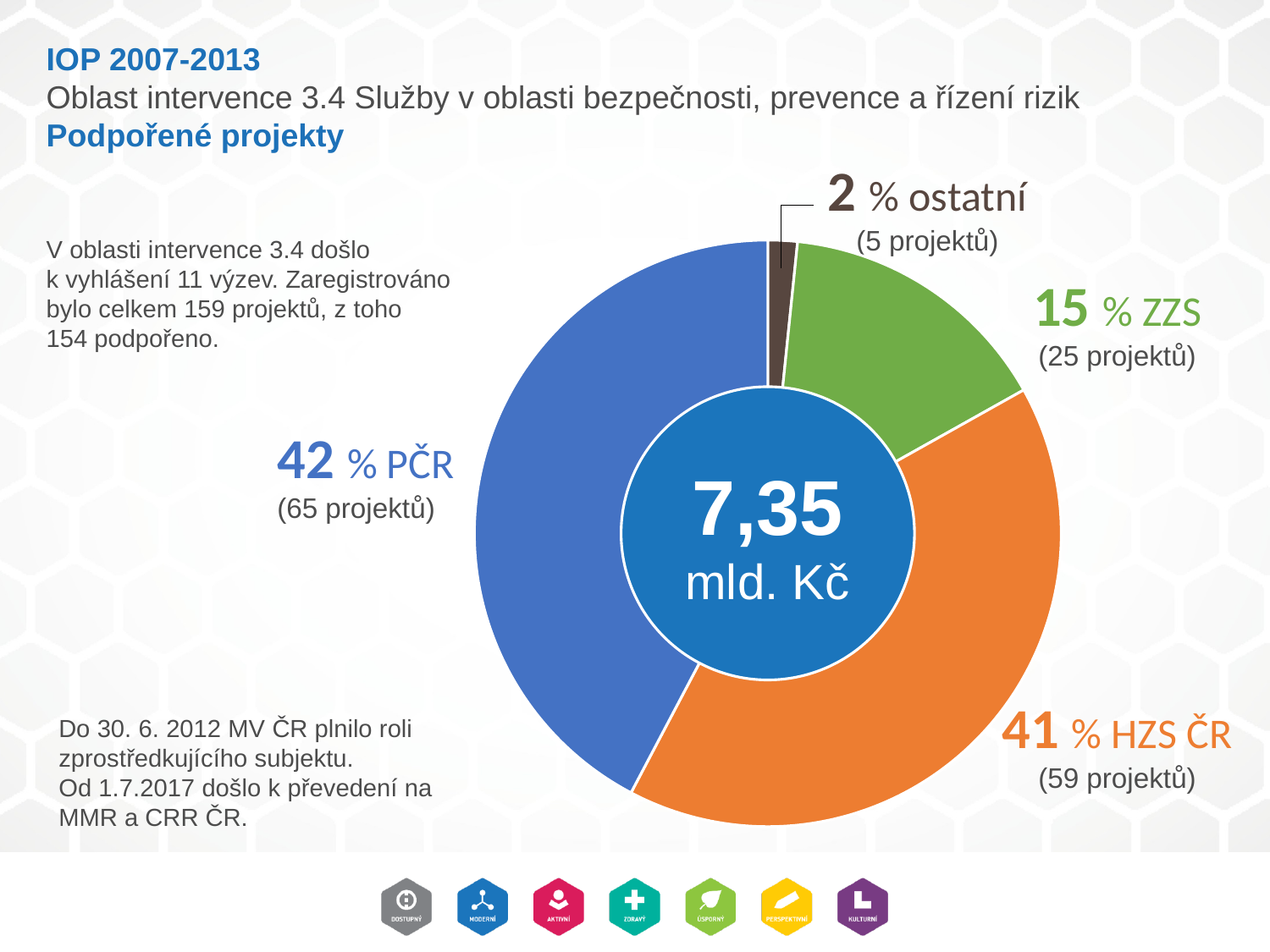
What percentage share does the 'ostatní' slice have in the pie chart? 2 % How many slices does the pie chart have? 4 Which category has the largest share of the pie chart? PČR What value is printed in the centre of the pie chart? 7,35 mld. Kč What is the difference in percentage points between the PČR share and the ZZS share? 27 What percentage share does PČR have in the pie chart? 42 % Which category has the smallest share of the pie chart? ostatní What percentage share does HZS ČR have in the pie chart? 41 % How many projects are attributed to HZS ČR in the pie chart? 59 projektů What kind of chart is shown on the slide? doughnut chart How many projects are attributed to ZZS in the pie chart? 25 projektů What percentage share does ZZS have in the pie chart? 15 %